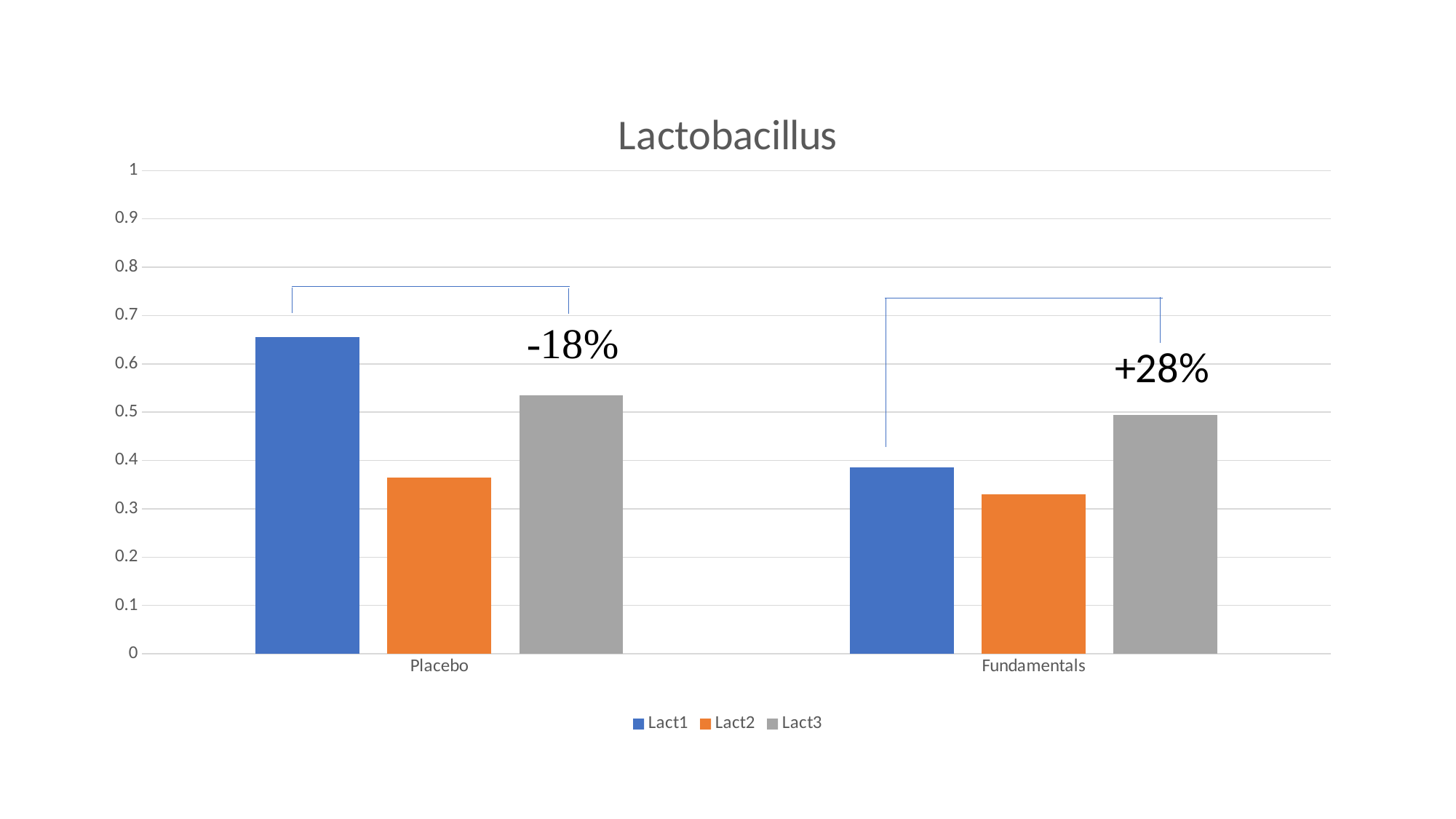
Is the Lact1 value for Placebo greater or less than 0.6? greater Which series has the highest value for Fundamentals? Lact3 Is the Lact1 value for Fundamentals greater or less than 0.5? less Which is larger, the Lact1 value for Placebo or the Lact1 value for Fundamentals? Placebo What percentage change is annotated above the Fundamentals group? +28% What kind of chart is shown on the slide? bar chart How many categories are shown on the x axis? 2 Which series has the highest value for Placebo? Lact1 Which series has the lowest value for Fundamentals? Lact2 Which series has the lowest value for Placebo? Lact2 How many series does the legend list? 3 What is the title of the chart? Lactobacillus